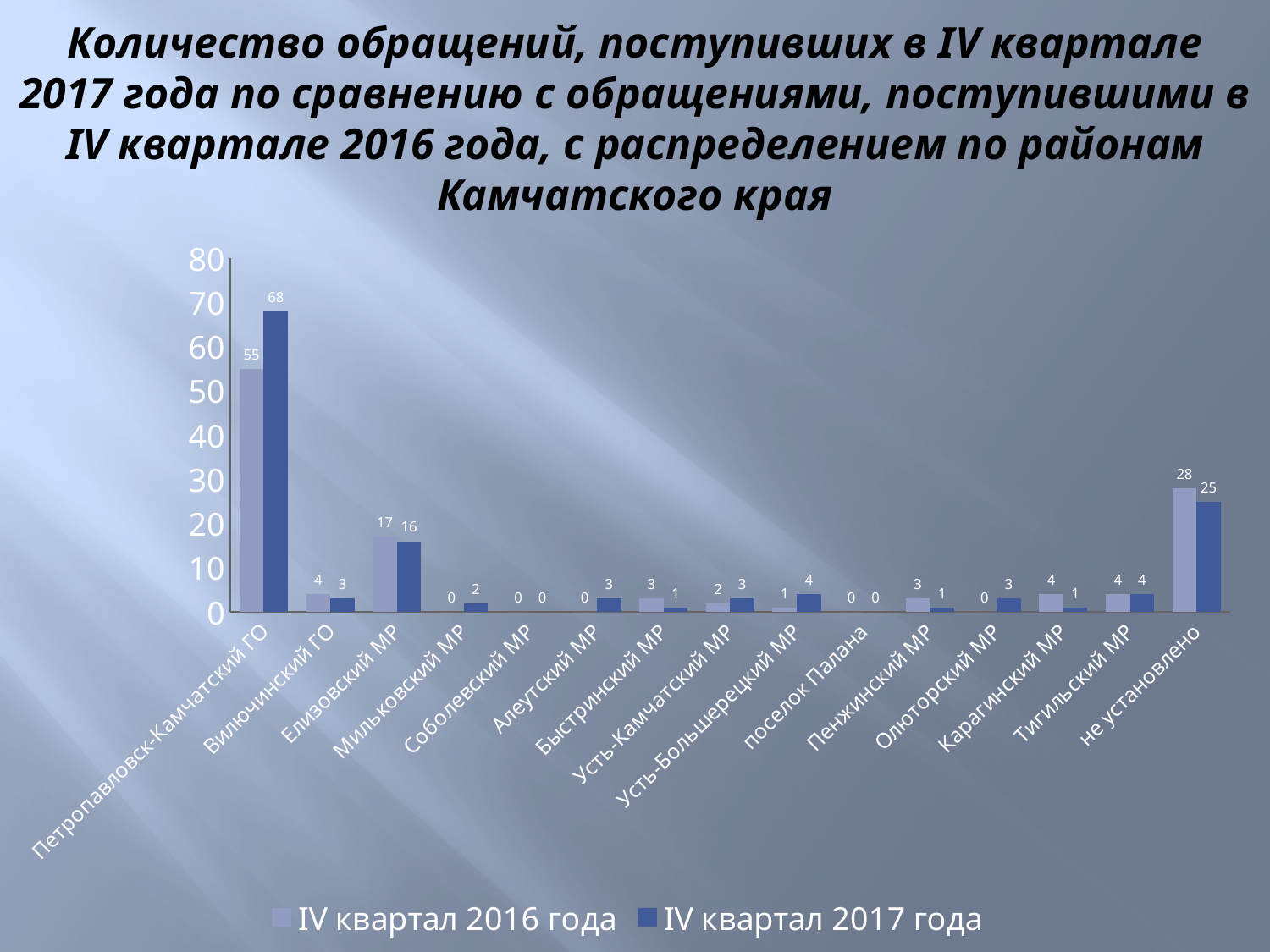
What is the difference between the IV квартал 2017 года and IV квартал 2016 года values for Петропавловск-Камчатский ГО? 13 Which category has the highest value in the IV квартал 2016 года series? Петропавловск-Камчатский ГО What is the value for Елизовский МР in the IV квартал 2016 года series? 17 Is the value for Петропавловск-Камчатский ГО in the IV квартал 2016 года series greater or less than 50? greater How many series does the legend list? 2 What is the value for Усть-Большерецкий МР in the IV квартал 2017 года series? 4 What is the value for не установлено in the IV квартал 2017 года series? 25 How many categories are shown on the x axis? 15 What is the value for Петропавловск-Камчатский ГО in the IV квартал 2017 года series? 68 What is the difference between the IV квартал 2016 года and IV квартал 2017 года values for не установлено? 3 Which is larger for Елизовский МР: the IV квартал 2016 года value or the IV квартал 2017 года value? IV квартал 2016 года What kind of chart is shown on the slide? bar chart